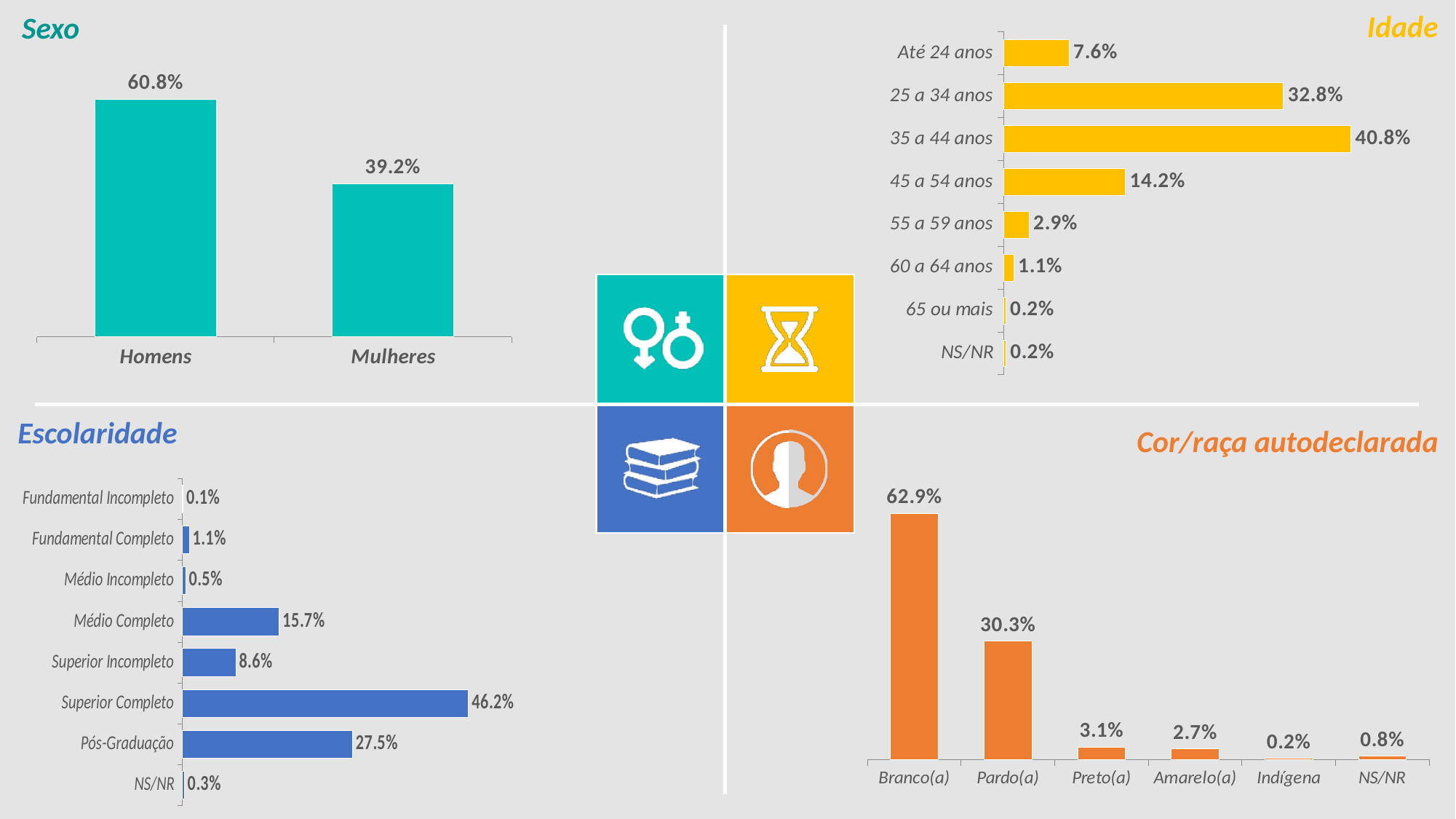
In the Cor/raça autodeclarada chart, what is the difference between Branco(a) and Pardo(a)? 32.6% In the Cor/raça autodeclarada chart, which is larger, Preto(a) or Amarelo(a)? Preto(a) In the Idade chart, which age group has the highest value? 35 a 44 anos In the Escolaridade chart, what is the value for Pós-Graduação? 27.5% In the Idade chart, what is the difference between 35 a 44 anos and 25 a 34 anos? 8.0% In the Escolaridade chart, which category has the lowest value? Fundamental Incompleto How many categories does the Escolaridade chart show? 8 In the Escolaridade chart, which category has the highest value? Superior Completo In the Sexo chart, what is the value for Homens? 60.8% In the Idade chart, what is the value for 45 a 54 anos? 14.2% In the Cor/raça autodeclarada chart, what is the value for Pardo(a)? 30.3% What kind of chart is the Idade chart? Bar chart